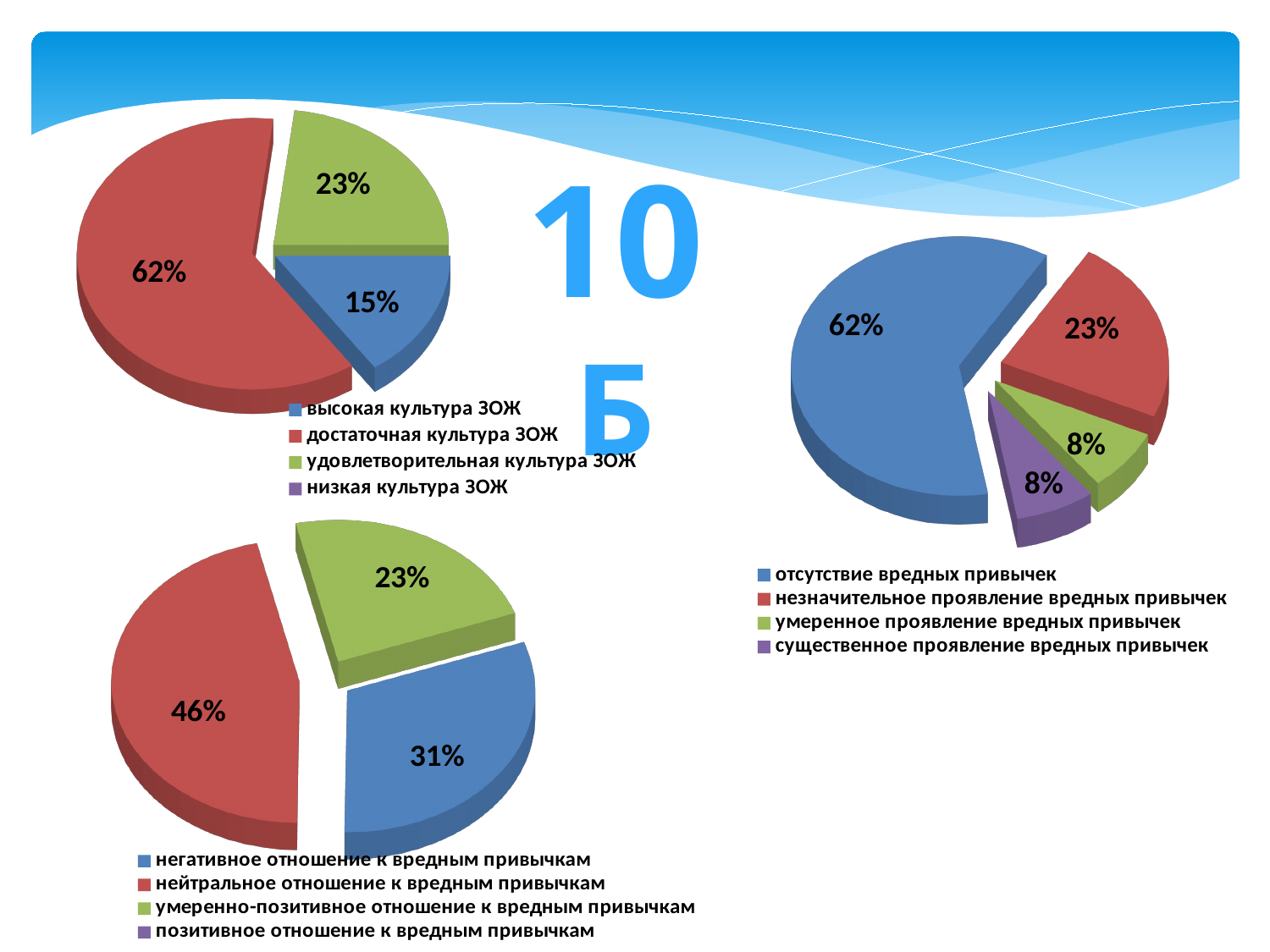
On the right-hand pie chart, what share is labelled for 'отсутствие вредных привычек'? 62% On the right-hand pie chart, what share is labelled for 'незначительное проявление вредных привычек'? 23% On the right-hand pie chart, how many entries does the legend list? 4 On the top-left pie chart, what share is labelled for 'достаточная культура ЗОЖ'? 62% On the top-left pie chart, what share is labelled for 'высокая культура ЗОЖ'? 15% On the bottom-left pie chart, what share is labelled for 'нейтральное отношение к вредным привычкам'? 46% What type of chart is the bottom-left chart? pie chart On the bottom-left pie chart, what is the difference between the shares for 'нейтральное отношение к вредным привычкам' and 'умеренно-позитивное отношение к вредным привычкам'? 23% On the top-left pie chart, what is the difference between the shares for 'достаточная культура ЗОЖ' and 'удовлетворительная культура ЗОЖ'? 39% On the bottom-left pie chart, what share is labelled for 'негативное отношение к вредным привычкам'? 31% On the right-hand pie chart, which is larger: 'незначительное проявление вредных привычек' or 'умеренное проявление вредных привычек'? незначительное проявление вредных привычек On the top-left pie chart, which category has the largest slice? достаточная культура ЗОЖ